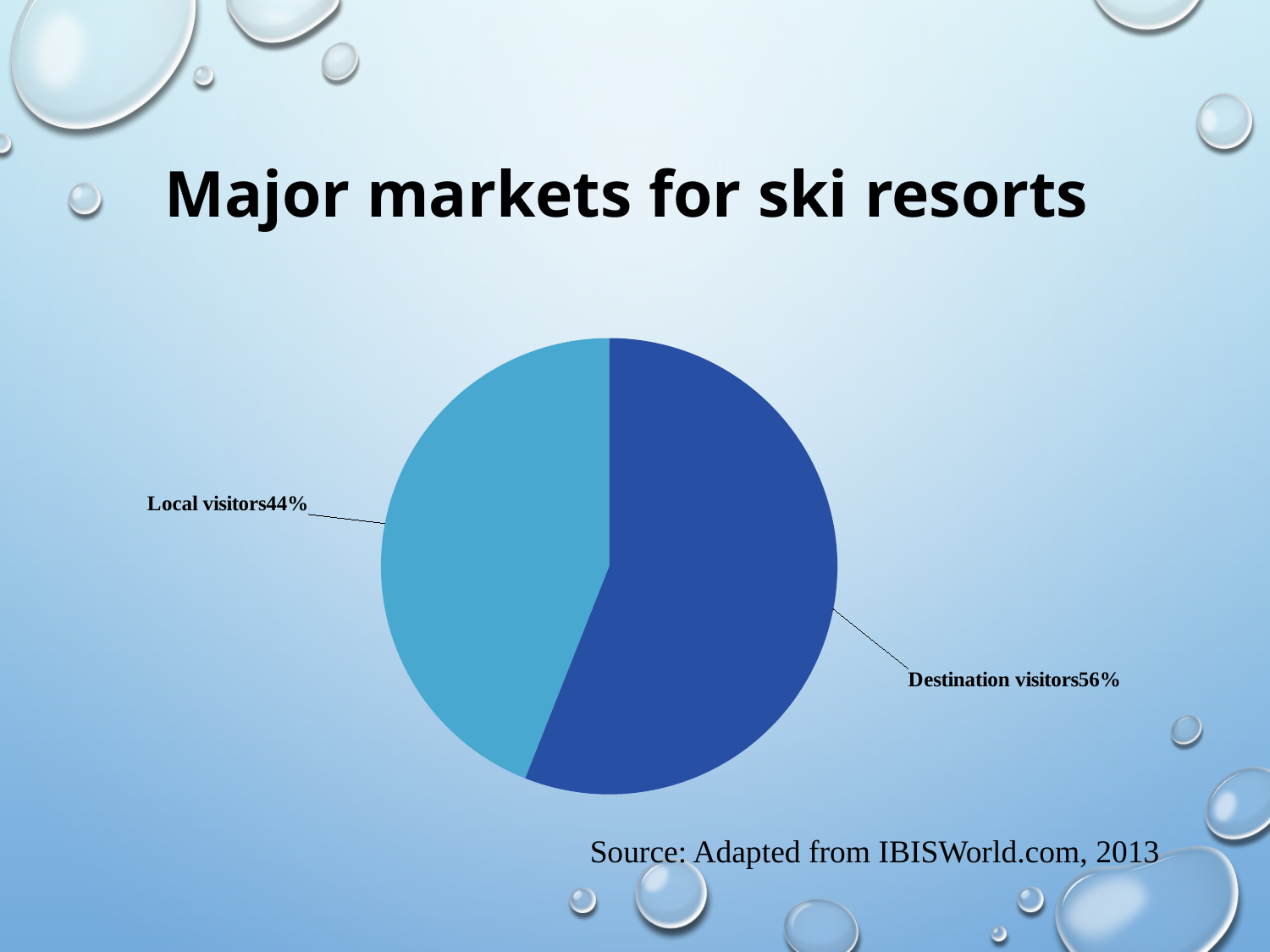
What is the title of the slide containing the pie chart? Major markets for ski resorts Is the share for Local visitors greater or less than 50%? less What is the difference in percentage points between Destination visitors and Local visitors? 12 What share of the pie do Destination visitors account for? 56% What source is cited for the pie chart data? Adapted from IBISWorld.com, 2013 Which is larger, the share for Local visitors or the share for Destination visitors? Destination visitors What kind of chart is shown on the slide? pie chart Which slice of the pie is the smallest? Local visitors Which slice of the pie is the largest? Destination visitors What share of the pie do Local visitors account for? 44% How many slices does the pie chart have? 2